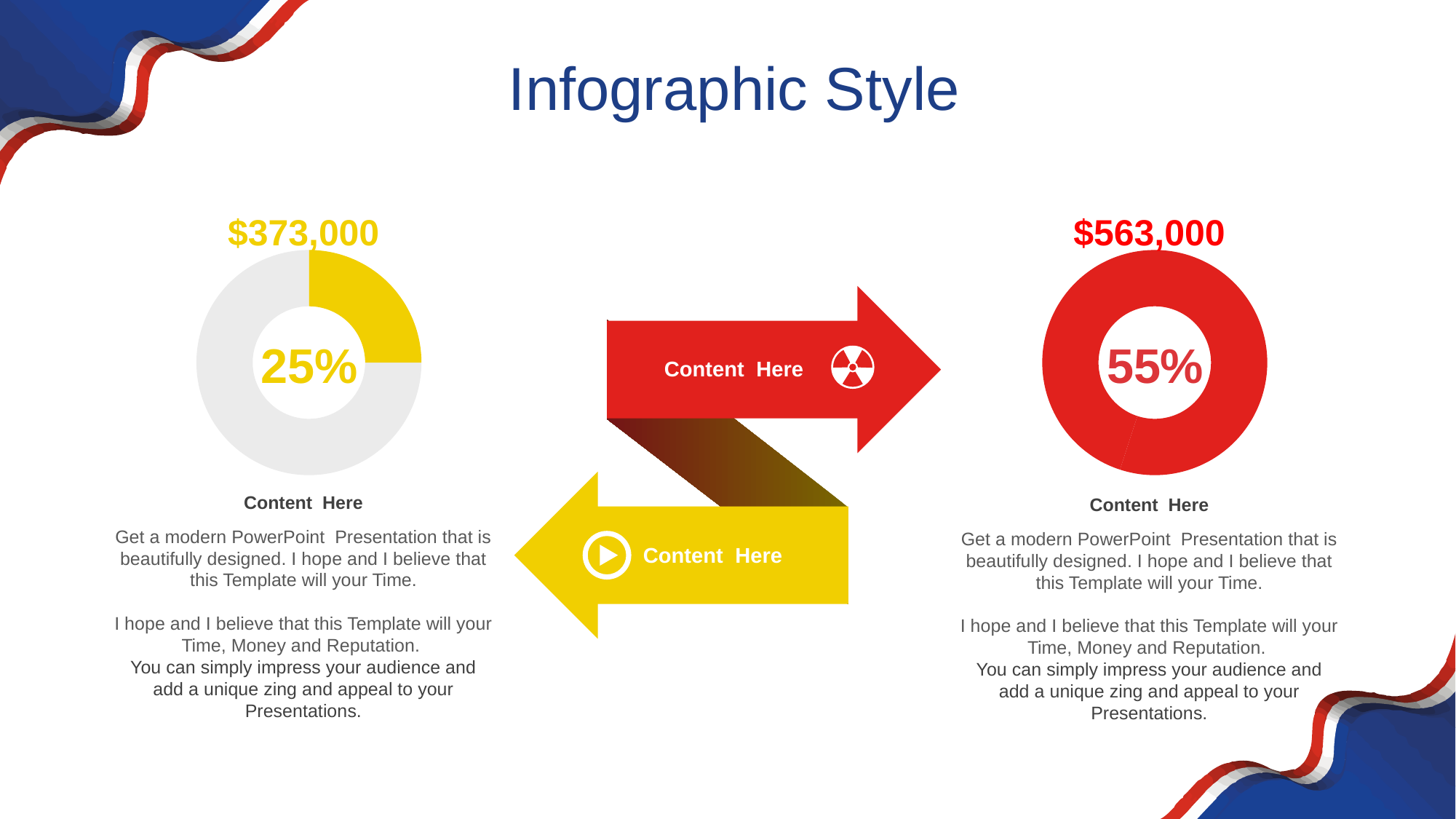
Is the percentage shown on the left doughnut chart greater or less than 50%? less What colour is the right doughnut chart? Red Which doughnut chart shows the larger percentage, the left one or the right one? The right one (55%) What kind of chart is used on the left side of the slide? Doughnut chart What dollar value is printed above the right doughnut chart? $563,000 On the left doughnut chart, what percentage is shown in the centre? 25% How many doughnut charts are on the slide? 2 On the right doughnut chart, what percentage is shown in the centre? 55% By how many percentage points does the right doughnut chart's value exceed the left doughnut chart's value? 30 percentage points What dollar value is printed above the left doughnut chart? $373,000 What is the difference between the dollar value above the right doughnut chart and the dollar value above the left doughnut chart? $190,000 What colour is the filled segment of the left doughnut chart? Yellow